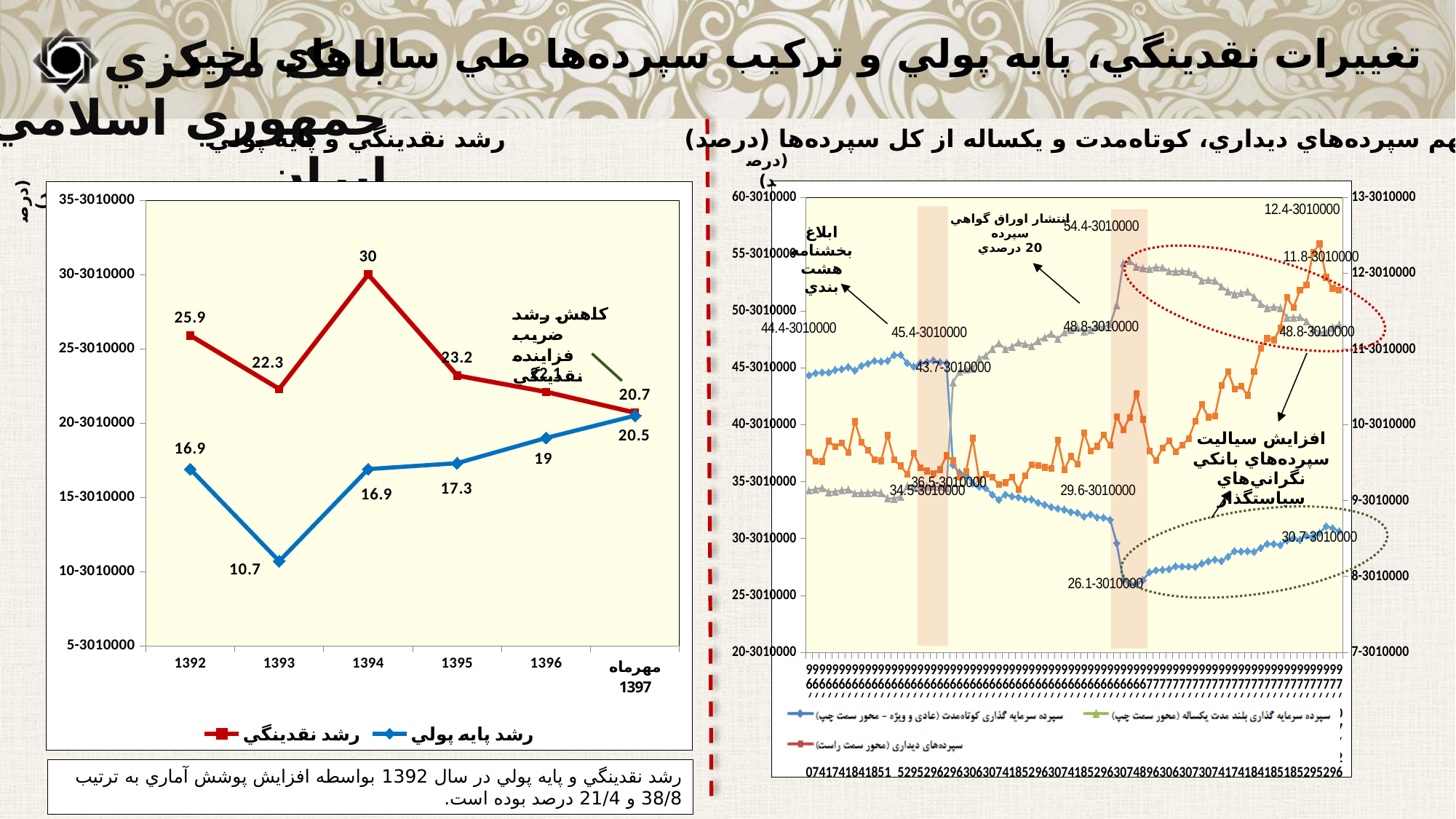
In the left chart, in which year does رشد نقدينگي reach its highest value? 1394 In the left chart, what is the difference between رشد نقدينگي and رشد پايه پولي in 1393? 11.6 In the left chart, in which year is رشد پايه پولي at its lowest? 1393 What kind of chart is the chart on the right side of the slide? line chart In the left chart, what is the value of رشد نقدينگي for 1394? 30 In the left chart, how many categories are shown on the x axis? 6 In the left chart, what is the value of رشد پايه پولي for 1393? 10.7 In the left chart, what is the value of رشد نقدينگي for مهرماه 1397? 20.7 In the left chart, does رشد پايه پولي rise or fall from 1393 to مهرماه 1397? rise In the left chart, how many series does the legend list? 2 In the left chart, which series has the larger value in 1392, رشد نقدينگي or رشد پايه پولي? رشد نقدينگي In the left chart, what is the value of رشد پايه پولي for 1396? 19